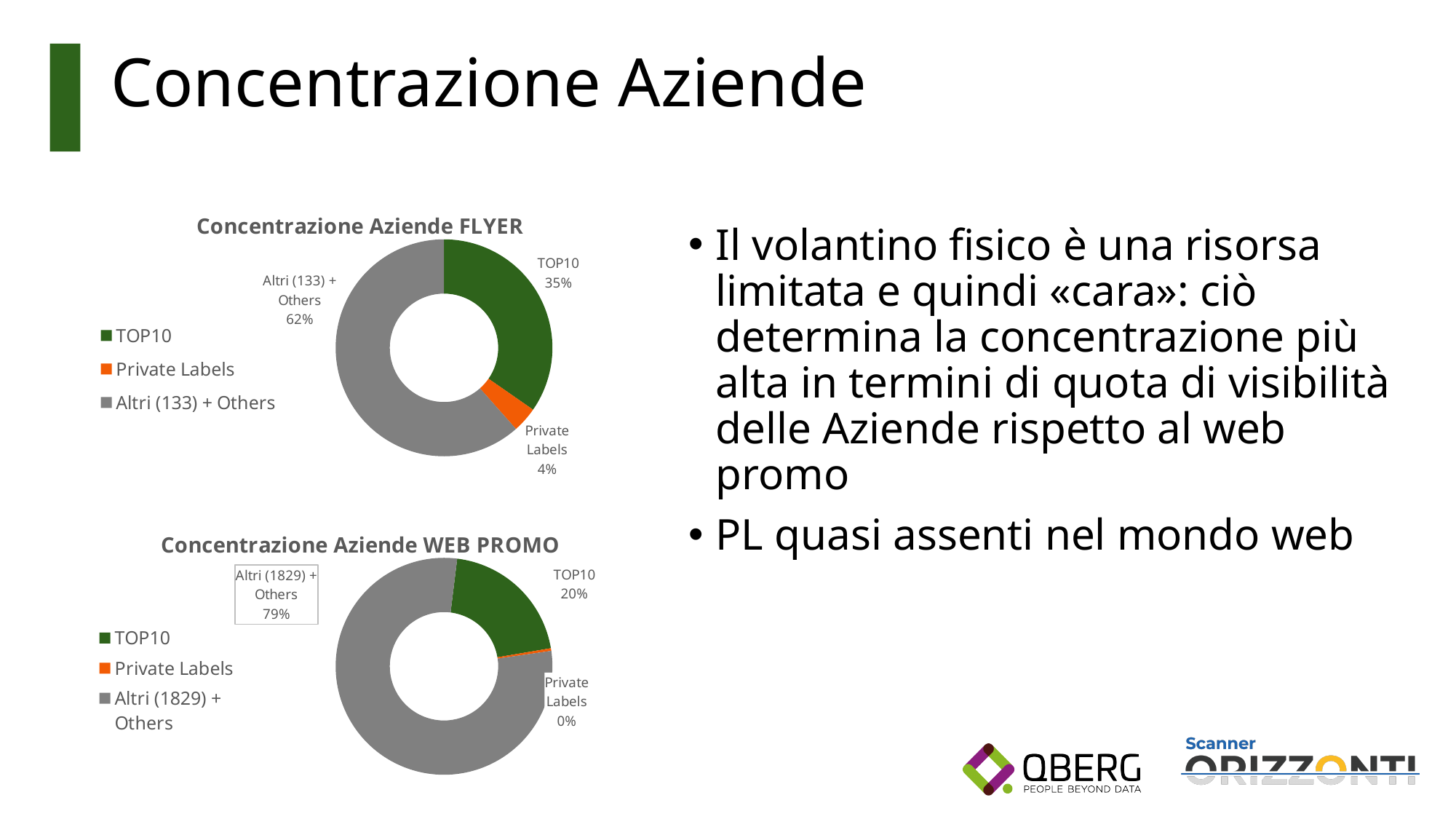
Which chart shows a larger share for TOP10, 'Concentrazione Aziende FLYER' or 'Concentrazione Aziende WEB PROMO'? Concentrazione Aziende FLYER In the 'Concentrazione Aziende FLYER' chart, what is the difference in percentage points between 'Altri (133) + Others' and TOP10? 27 In the 'Concentrazione Aziende FLYER' chart, which category has the largest share? Altri (133) + Others In the 'Concentrazione Aziende FLYER' chart, what share does 'Altri (133) + Others' have? 62% In the 'Concentrazione Aziende WEB PROMO' chart, what share do Private Labels have? 0% What type of chart is 'Concentrazione Aziende FLYER'? Doughnut chart In the 'Concentrazione Aziende WEB PROMO' chart, what share does 'Altri (1829) + Others' have? 79% How many series does the legend of the 'Concentrazione Aziende WEB PROMO' chart list? 3 In the 'Concentrazione Aziende FLYER' chart, what share do Private Labels have? 4% In the 'Concentrazione Aziende WEB PROMO' chart, what share does TOP10 have? 20% In the 'Concentrazione Aziende WEB PROMO' chart, which category has the smallest share? Private Labels In the 'Concentrazione Aziende FLYER' chart, what share does TOP10 have? 35%